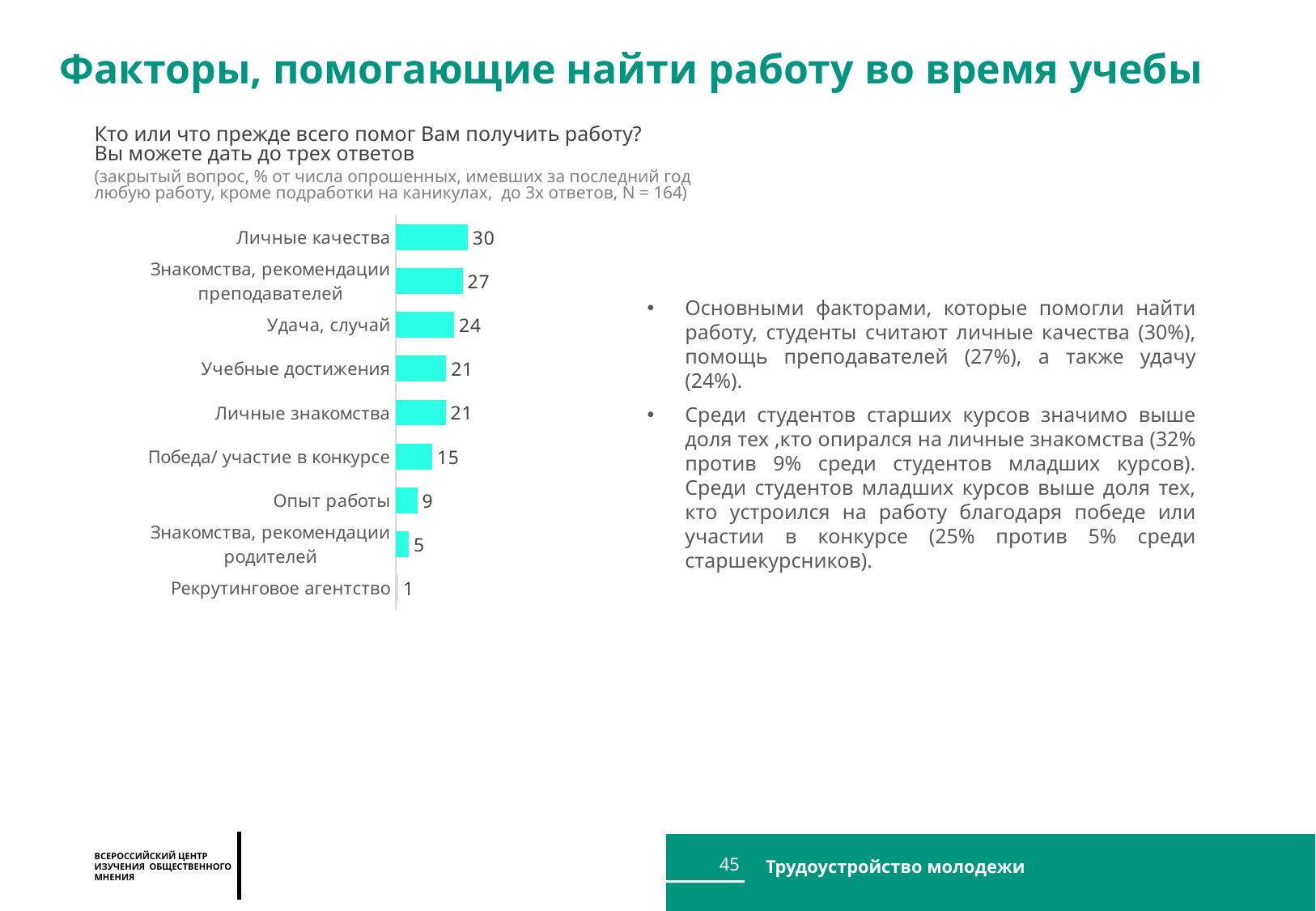
What is the difference between «Учебные достижения» and «Знакомства, рекомендации родителей»? 16 What is the value for «Победа/ участие в конкурсе»? 15 What is the value for «Личные качества»? 30 What kind of chart is shown on the slide? Bar chart Which category has the highest value? Личные качества What is the value for «Опыт работы»? 9 Which is larger: «Удача, случай» or «Личные знакомства»? Удача, случай What is the difference between «Личные качества» and «Знакомства, рекомендации преподавателей»? 3 Which category has the lowest value? Рекрутинговое агентство What is the value for «Удача, случай»? 24 How many categories are shown in the chart? 9 What colour are the bars in the chart? Turquoise